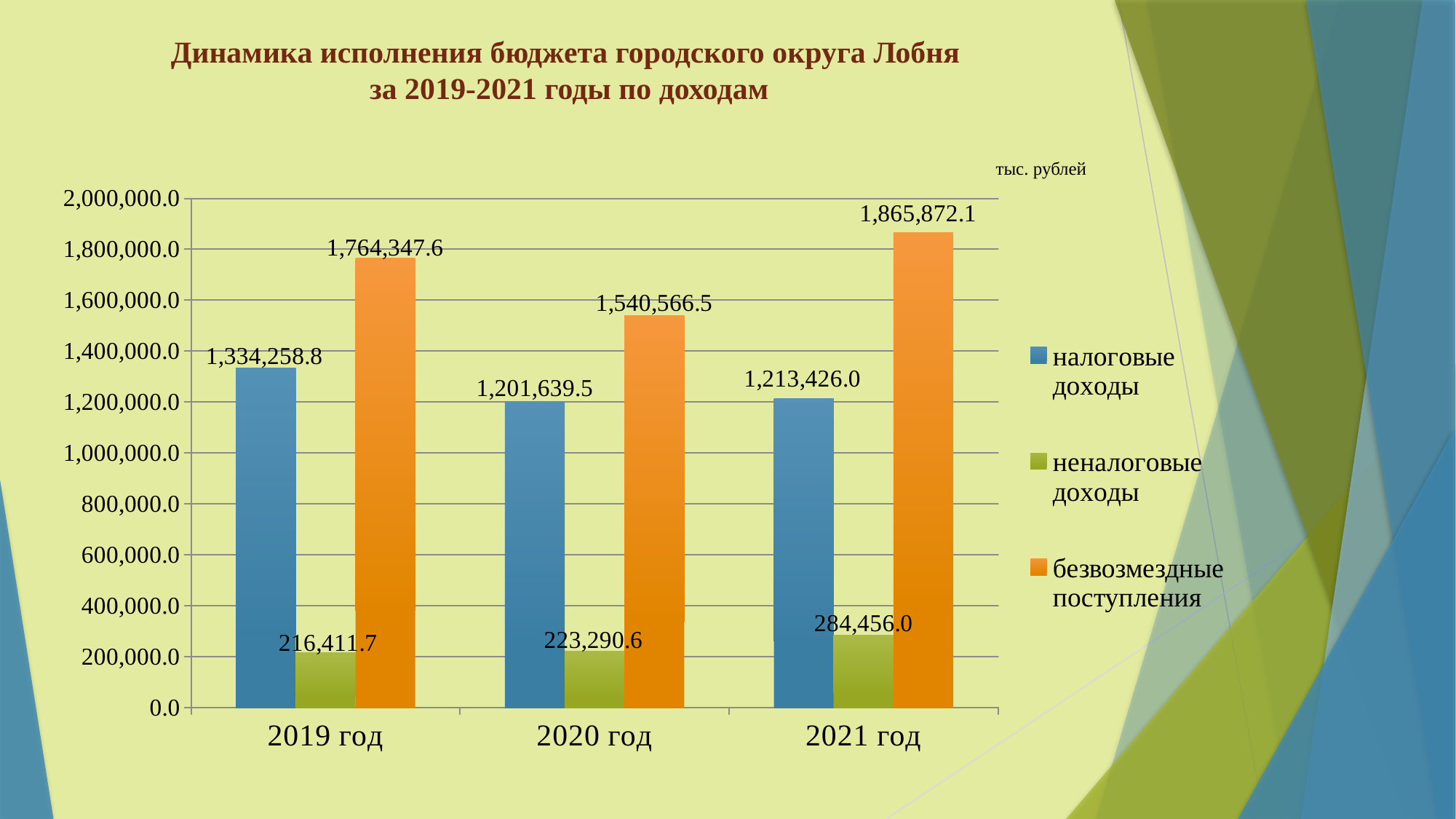
What is the value for безвозмездные поступления in 2021 год? 1,865,872.1 What is the difference between безвозмездные поступления in 2021 год and in 2019 год? 101,524.5 In which year are безвозмездные поступления highest? 2021 год What is the value for неналоговые доходы in 2020 год? 223,290.6 Which is larger in 2020 год: налоговые доходы or безвозмездные поступления? безвозмездные поступления What is the difference between неналоговые доходы in 2021 год and in 2019 год? 68,044.3 What is the value for налоговые доходы in 2019 год? 1,334,258.8 Is the value for налоговые доходы in 2021 год greater or less than 1,400,000.0? less What kind of chart is shown on the slide? bar chart In which year are неналоговые доходы lowest? 2019 год Do the values for неналоговые доходы rise or fall from 2019 год to 2021 год? rise How many series does the legend list? 3